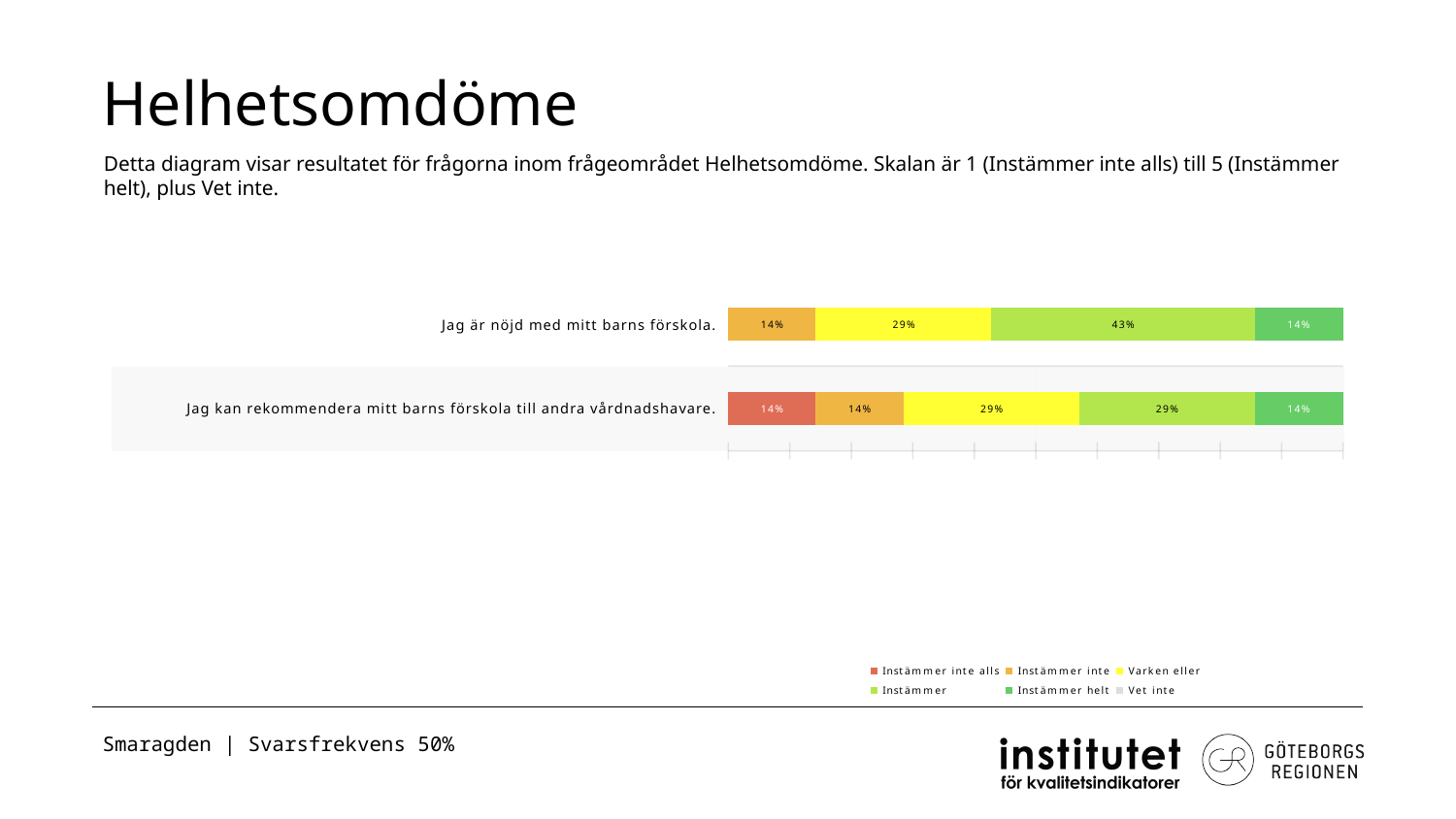
How many categories (statements) are plotted in the chart? 2 Which segment is the largest in the bar for 'Jag är nöjd med mitt barns förskola.'? Instämmer What is the value of the 'Instämmer helt' segment for 'Jag kan rekommendera mitt barns förskola till andra vårdnadshavare.'? 14% Which legend entry is shown in red? Instämmer inte alls What is the value of the 'Instämmer' segment for 'Jag är nöjd med mitt barns förskola.'? 43% What is the combined share of 'Instämmer' and 'Instämmer helt' for 'Jag kan rekommendera mitt barns förskola till andra vårdnadshavare.'? 43% Which statement has the larger 'Instämmer' segment: 'Jag är nöjd med mitt barns förskola.' or 'Jag kan rekommendera mitt barns förskola till andra vårdnadshavare.'? Jag är nöjd med mitt barns förskola. How many series does the legend list? 6 What is the value of the 'Varken eller' segment for 'Jag är nöjd med mitt barns förskola.'? 29% What is the value of the 'Instämmer inte alls' segment for 'Jag kan rekommendera mitt barns förskola till andra vårdnadshavare.'? 14% What kind of chart is shown on the slide? Stacked bar chart What is the difference between the 'Instämmer' values for 'Jag är nöjd med mitt barns förskola.' and 'Jag kan rekommendera mitt barns förskola till andra vårdnadshavare.'? 14%